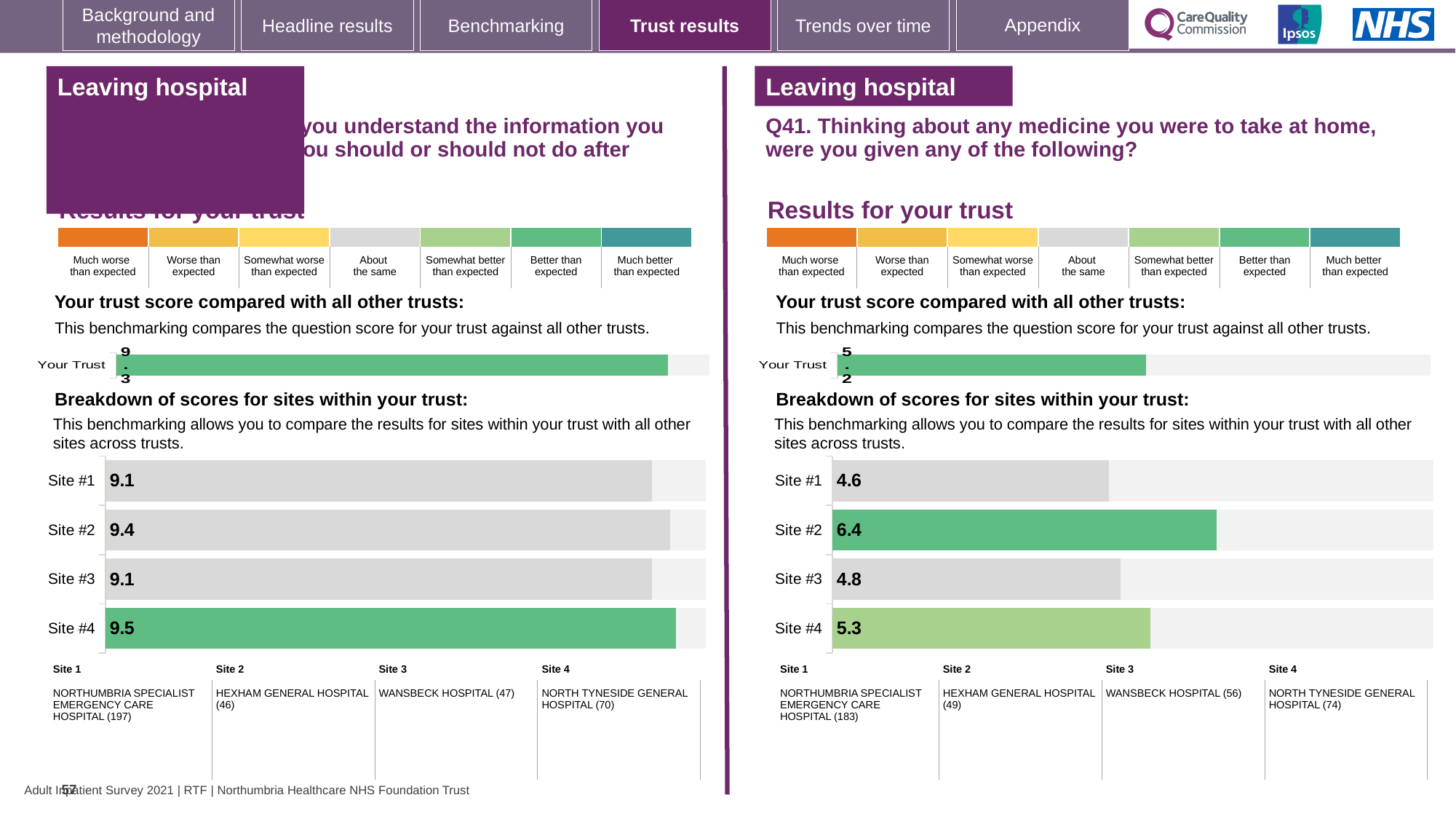
What type of chart is used for the breakdown of scores for sites on the right-hand side? Bar chart On the right-hand chart (Q41), which site has the highest score? Site #2 On the right-hand chart (Q41), what is the difference between the scores for Site #2 and Site #1? 1.8 On the right-hand chart (Q41), what is the score for Site #2? 6.4 On the left-hand chart, what is the 'Your Trust' score? 9.3 On the right-hand chart (Q41), what is the 'Your Trust' score? 5.2 On the left-hand chart, what is the score for Site #4? 9.5 On the right-hand chart (Q41), which site has the lowest score? Site #1 How many sites are shown in the site breakdown chart on the left-hand side? 4 On the left-hand chart, which site has the highest score? Site #4 On the right-hand chart (Q41), which has the larger score, Site #3 or Site #4? Site #4 On the left-hand chart, what is the difference between the scores for Site #4 and Site #2? 0.1